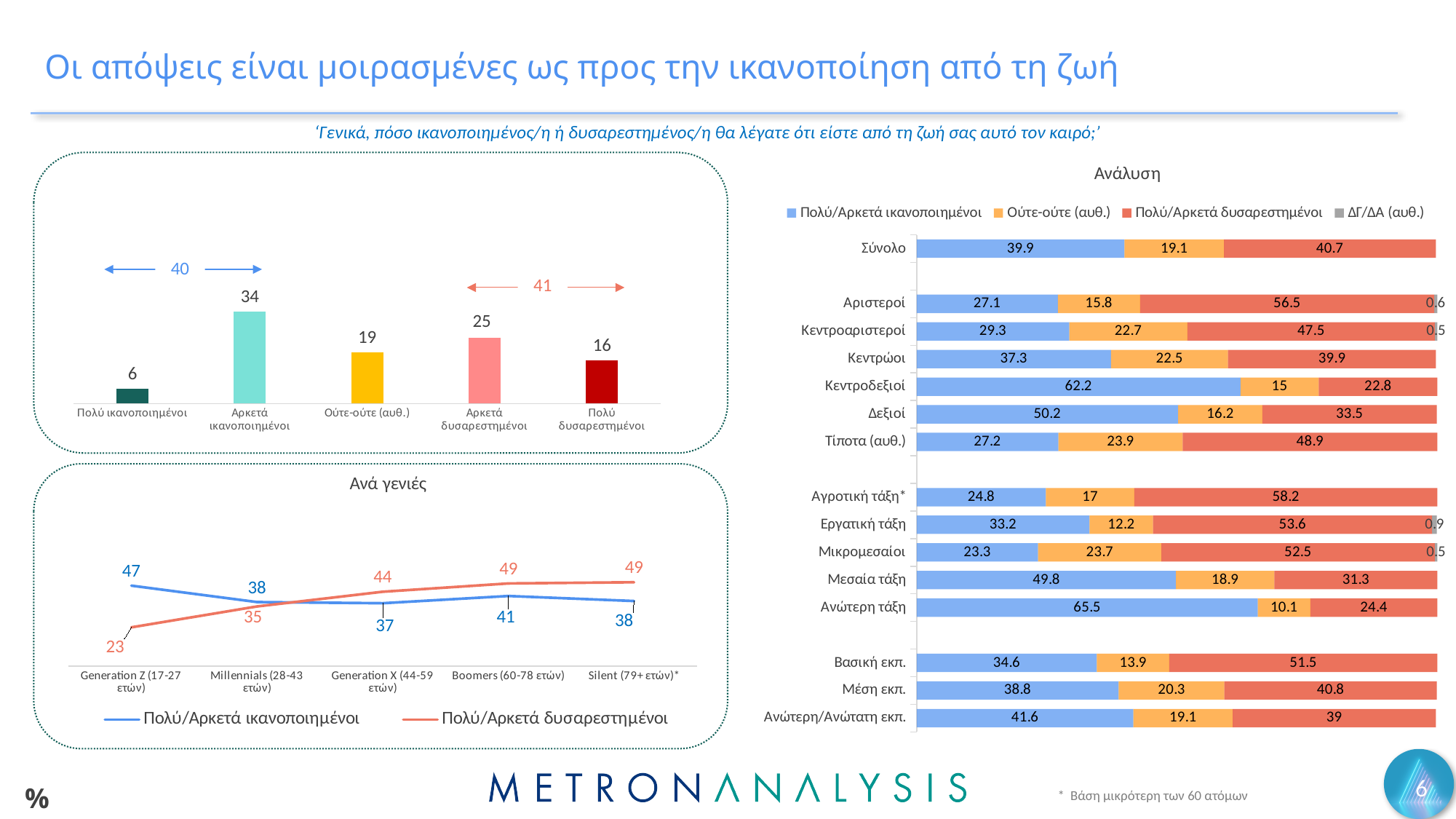
How many series does the legend of the 'Ανά γενιές' chart list? 2 In the 'Ανά γενιές' chart, what is the difference between Πολύ/Αρκετά δυσαρεστημένοι and Πολύ/Αρκετά ικανοποιημένοι for Boomers (60-78 ετών)? 8 In the top-left bar chart, which category has the lowest value? Πολύ ικανοποιημένοι In the top-left bar chart, what is the value for Αρκετά ικανοποιημένοι? 34 In the 'Ανά γενιές' chart, does the Πολύ/Αρκετά δυσαρεστημένοι line rise or fall from Generation Z to Silent? Rises How many bars are shown in the top-left bar chart? 5 In the 'Ανάλυση' chart, which category has the highest Πολύ/Αρκετά ικανοποιημένοι value? Ανώτερη τάξη In the 'Ανά γενιές' chart, what is the value of Πολύ/Αρκετά δυσαρεστημένοι for Generation Z (17-27 ετών)? 23 In the 'Ανάλυση' chart, what is the Πολύ/Αρκετά ικανοποιημένοι value for Κεντροδεξιοί? 62.2 What kind of chart is the top-left chart on the slide? Bar chart How many series does the legend of the 'Ανάλυση' chart list? 4 In the 'Ανάλυση' chart, which has the larger Πολύ/Αρκετά δυσαρεστημένοι value, Αριστεροί or Δεξιοί? Αριστεροί